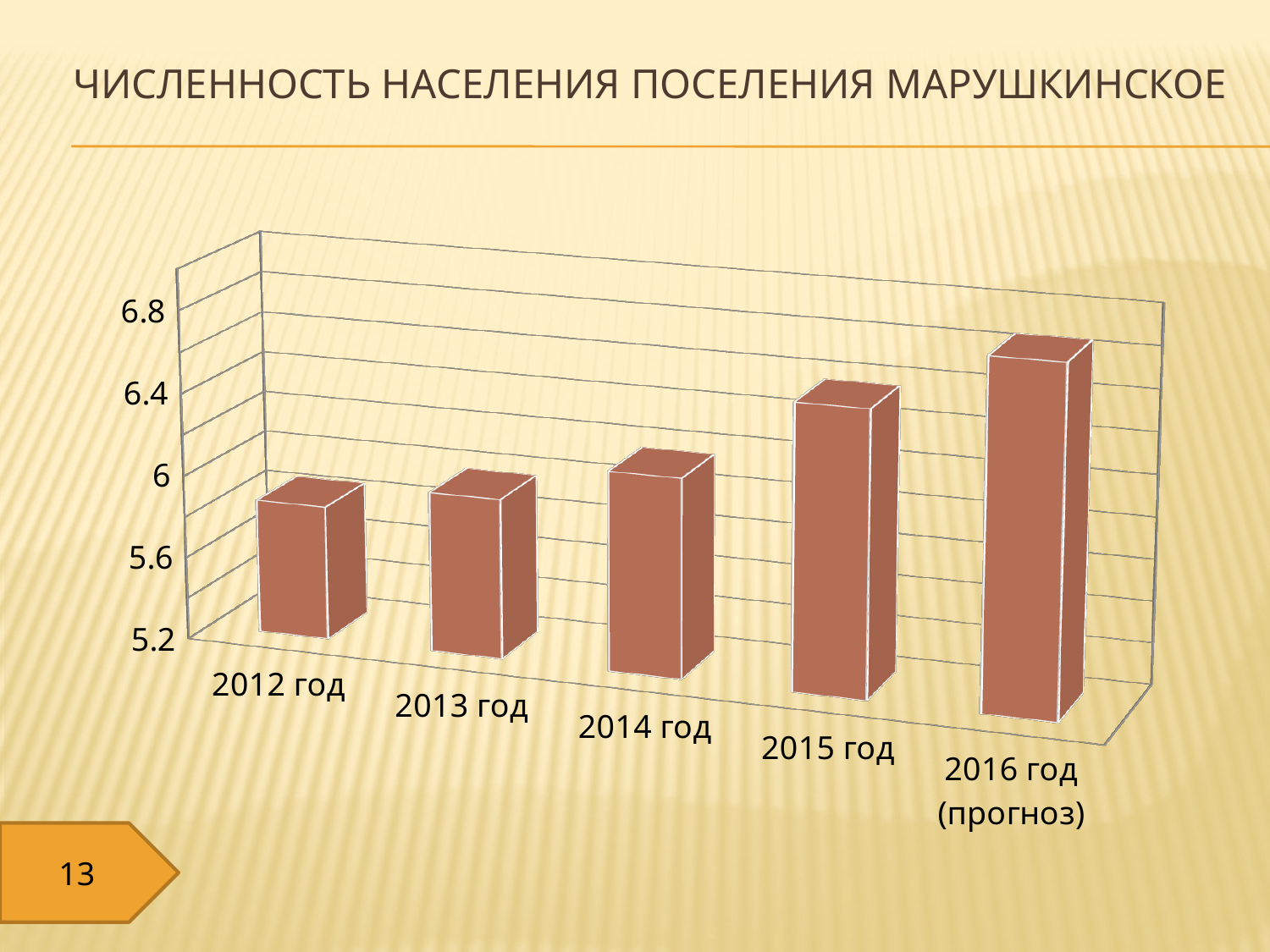
Do the values rise or fall from 2012 год to 2016 год (прогноз)? rise Which is larger, the value for 2012 год or the value for 2016 год (прогноз)? 2016 год (прогноз) Is the value for 2012 год greater or less than 6? less Is the value for 2015 год greater or less than 6? greater Is the value for 2013 год greater or less than 5.6? greater Which year has the highest value in the chart? 2016 год (прогноз) Which is larger, the value for 2014 год or the value for 2015 год? 2015 год What kind of chart is shown on the slide? bar chart What is the title of the chart on the slide? ЧИСЛЕННОСТЬ НАСЕЛЕНИЯ ПОСЕЛЕНИЯ МАРУШКИНСКОЕ How many categories (years) are shown on the x axis of the chart? 5 What is the lowest value shown on the vertical axis of the chart? 5.2